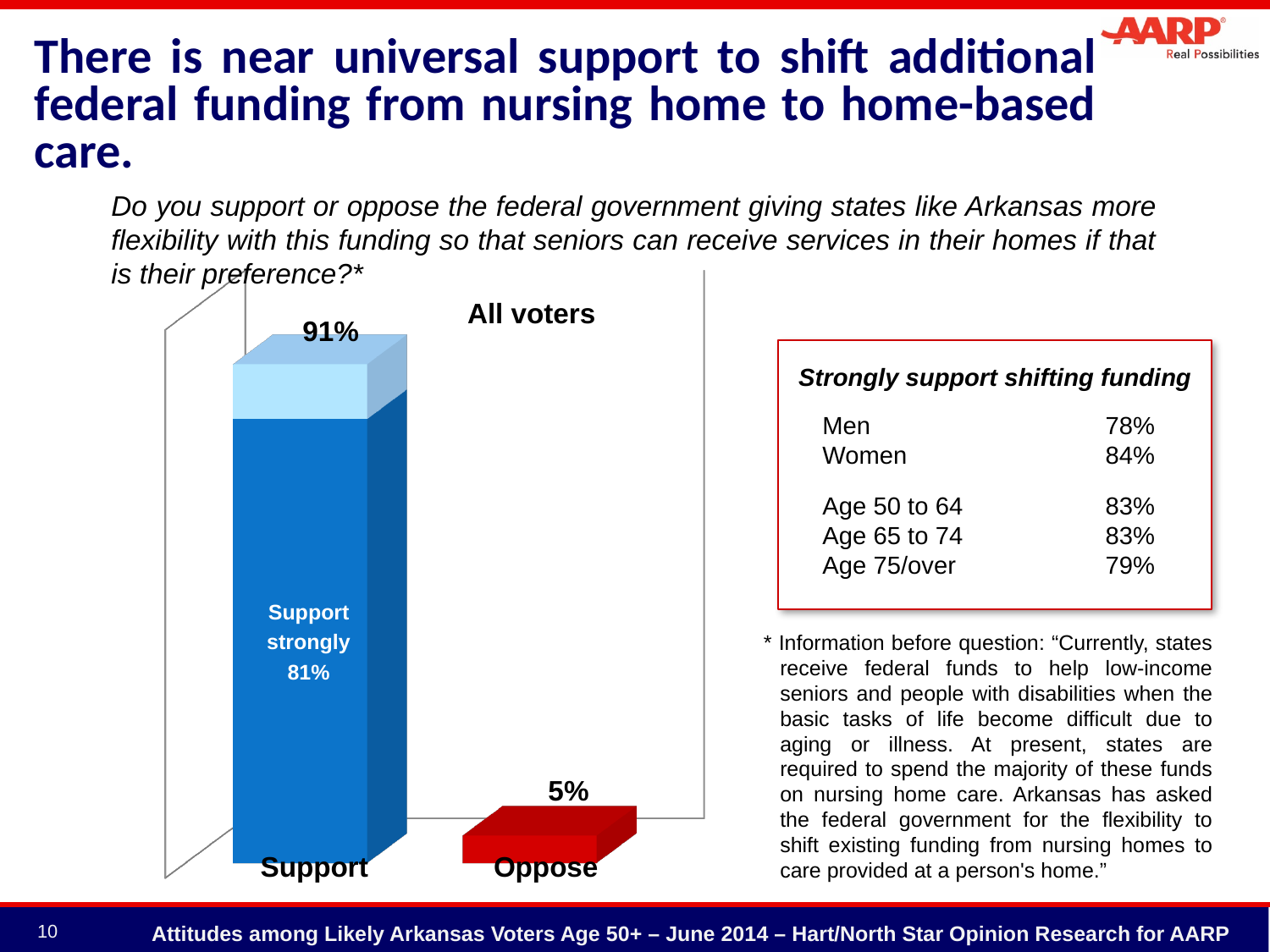
What is the difference between the Support and Oppose percentages in the bar chart? 86% Which category has the highest value in the bar chart? Support Which is larger in the bar chart, Support or Oppose? Support Which category has the lowest value in the bar chart? Oppose What percentage of all voters oppose, according to the bar chart? 5% How many categories are shown on the x axis of the bar chart? 2 What percentage of all voters support shifting funding, according to the bar chart? 91% What percentage of all voters 'Support strongly' in the bar chart? 81% What kind of chart is shown on the slide? Bar chart What is the title shown above the bar chart? All voters How much larger is the total Support percentage than the 'Support strongly' percentage? 10% What colour is the Oppose bar in the chart? Red